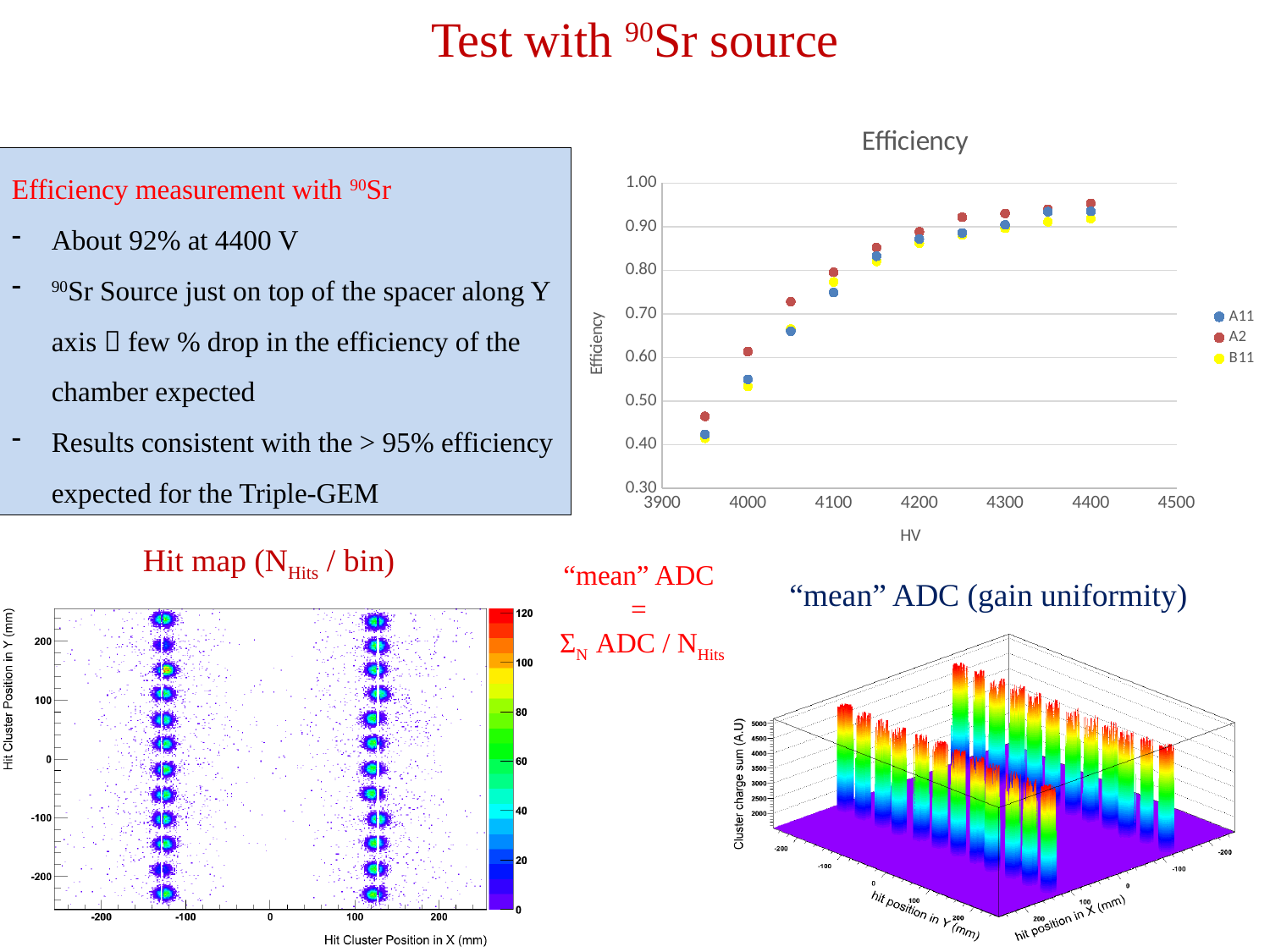
What kind of chart is the Efficiency chart at the top right of the slide? scatter chart In the Efficiency chart, is the efficiency of B11 at 4100 V greater or less than 0.80? less In the Efficiency chart, is the efficiency of A2 at 4400 V greater or less than 0.90? greater In the Efficiency chart, which series has the lower efficiency at 4000 V, A2 or B11? B11 What are the series names in the legend of the Efficiency chart? A11, A2, B11 In the Efficiency chart, is the efficiency of A11 at 3950 V greater or less than 0.50? less How many series does the legend of the Efficiency chart list? 3 What is the label of the x axis of the Efficiency chart? HV In the Efficiency chart, how many data points are plotted for the A2 series? 10 In the Efficiency chart, which series has the highest efficiency at 3950 V? A2 In the Efficiency chart, do the efficiency values rise or fall as HV increases? rise In the Efficiency chart, which series has the highest efficiency at 4400 V? A2